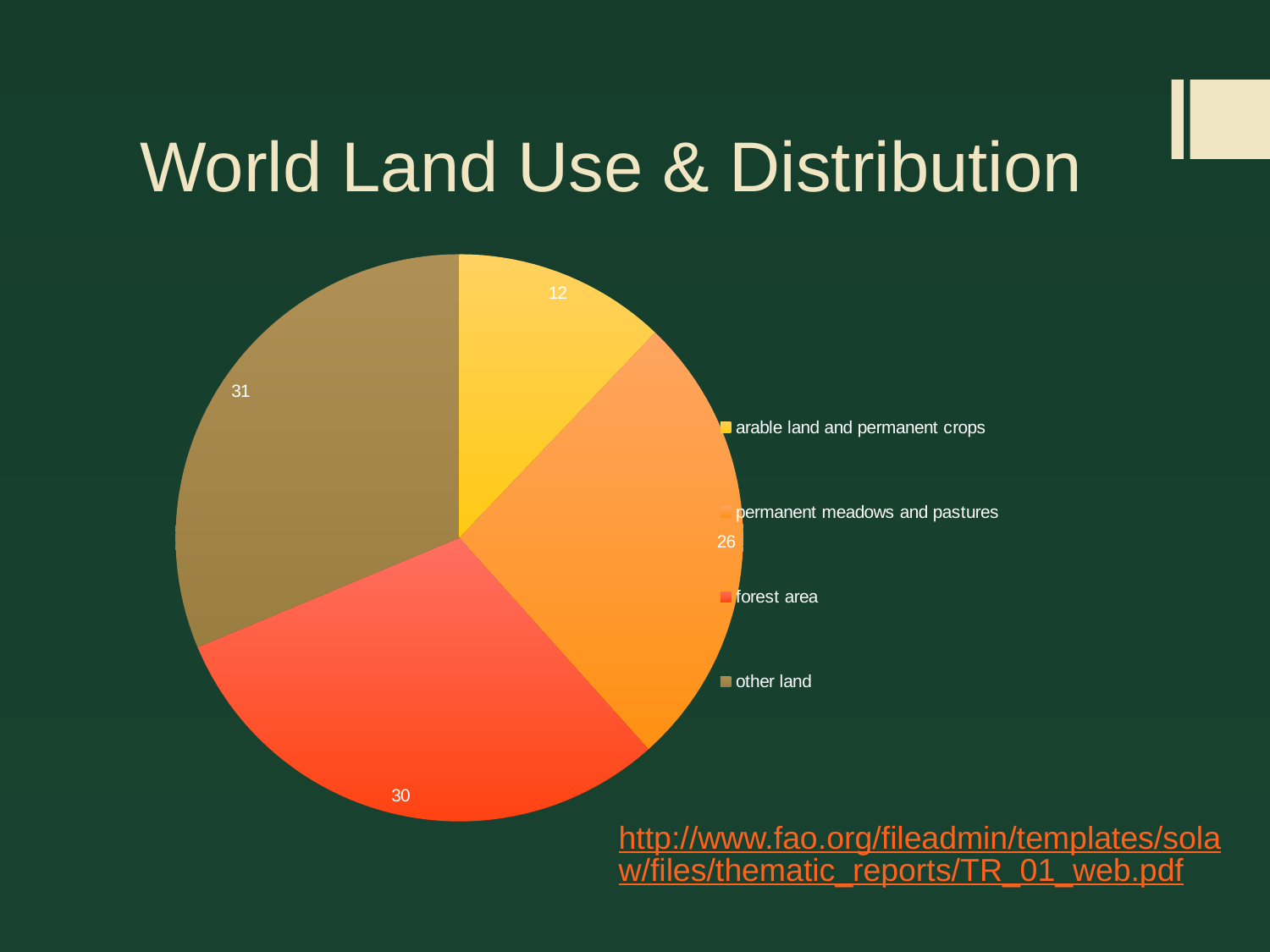
What is the value for permanent meadows and pastures? 26 What is the value for arable land and permanent crops? 12 Which category has the largest value according to the data labels? other land What is the difference between the values for other land and permanent meadows and pastures? 5 What is the value for forest area? 30 What is the title of the slide containing the chart? World Land Use & Distribution What is the difference between the values for forest area and arable land and permanent crops? 18 How many categories does the pie chart have? 4 What is the value for other land? 31 Which is larger, the value for permanent meadows and pastures or the value for arable land and permanent crops? permanent meadows and pastures What type of chart is shown on the slide? pie chart Which category has the smallest slice of the pie? arable land and permanent crops